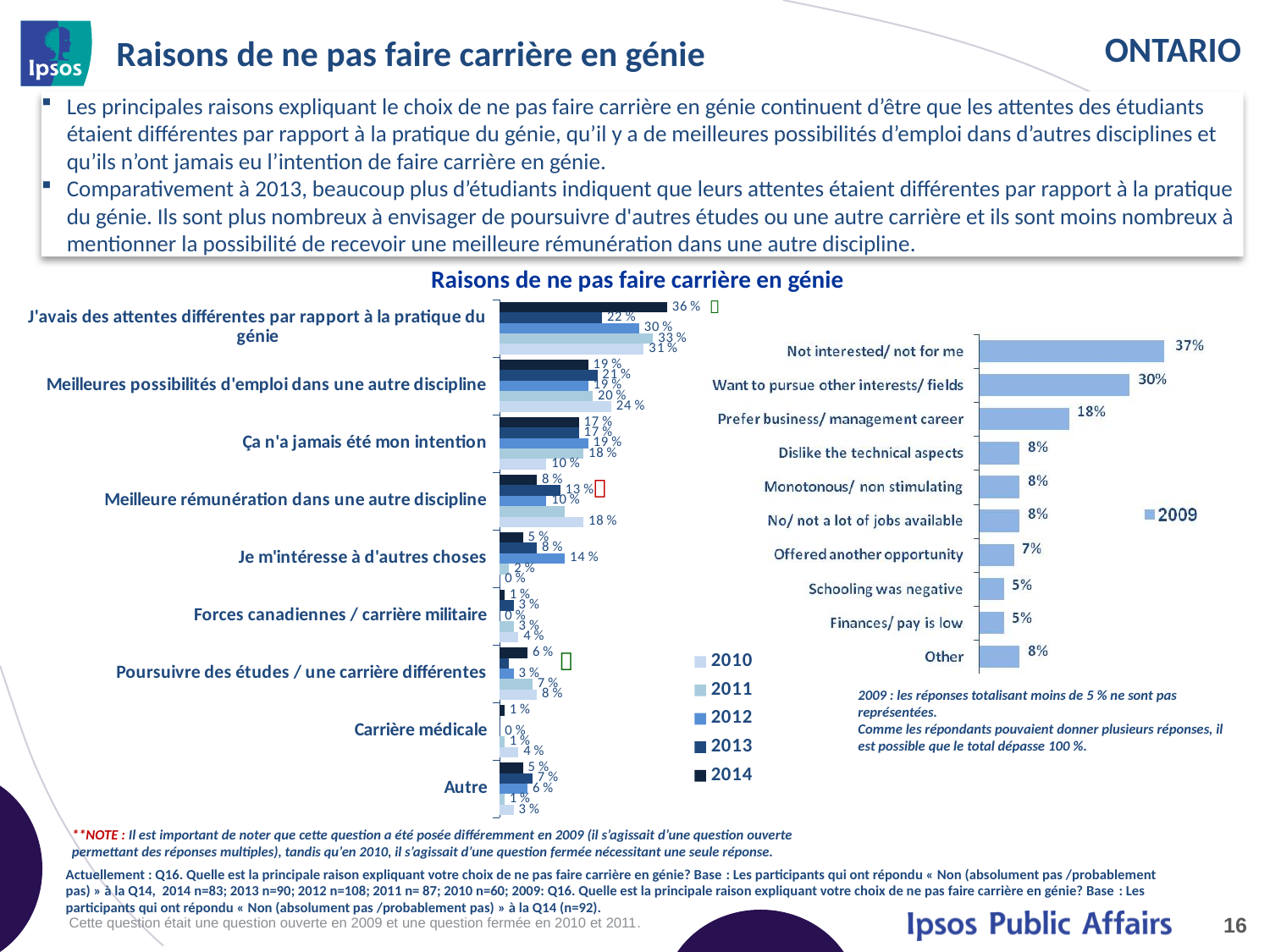
In the left-hand chart 'Raisons de ne pas faire carrière en génie', how many series does the legend list? 5 In the right-hand chart (2009 data), what percentage is shown for 'Prefer business/ management career'? 18% In the right-hand chart (2009 data), which category has the highest value? Not interested/ not for me What type of chart is the right-hand chart (2009 data)? Bar chart In the right-hand chart (2009 data), what percentage is shown for 'Not interested/ not for me'? 37% In the left-hand chart 'Raisons de ne pas faire carrière en génie', which years are listed in the legend? 2010, 2011, 2012, 2013, 2014 In the left-hand chart 'Raisons de ne pas faire carrière en génie', what is the 2014 value for 'J'avais des attentes différentes par rapport à la pratique du génie'? 36 % In the left-hand chart 'Raisons de ne pas faire carrière en génie', what is the difference between the 2014 and 2013 values for 'J'avais des attentes différentes par rapport à la pratique du génie'? 14 percentage points In the right-hand chart (2009 data), what is the difference between 'Not interested/ not for me' and 'Want to pursue other interests/ fields'? 7 percentage points In the right-hand chart (2009 data), how many categories are plotted? 10 In the left-hand chart 'Raisons de ne pas faire carrière en génie', how many categories are plotted? 9 In the right-hand chart (2009 data), how many series does the legend list? 1